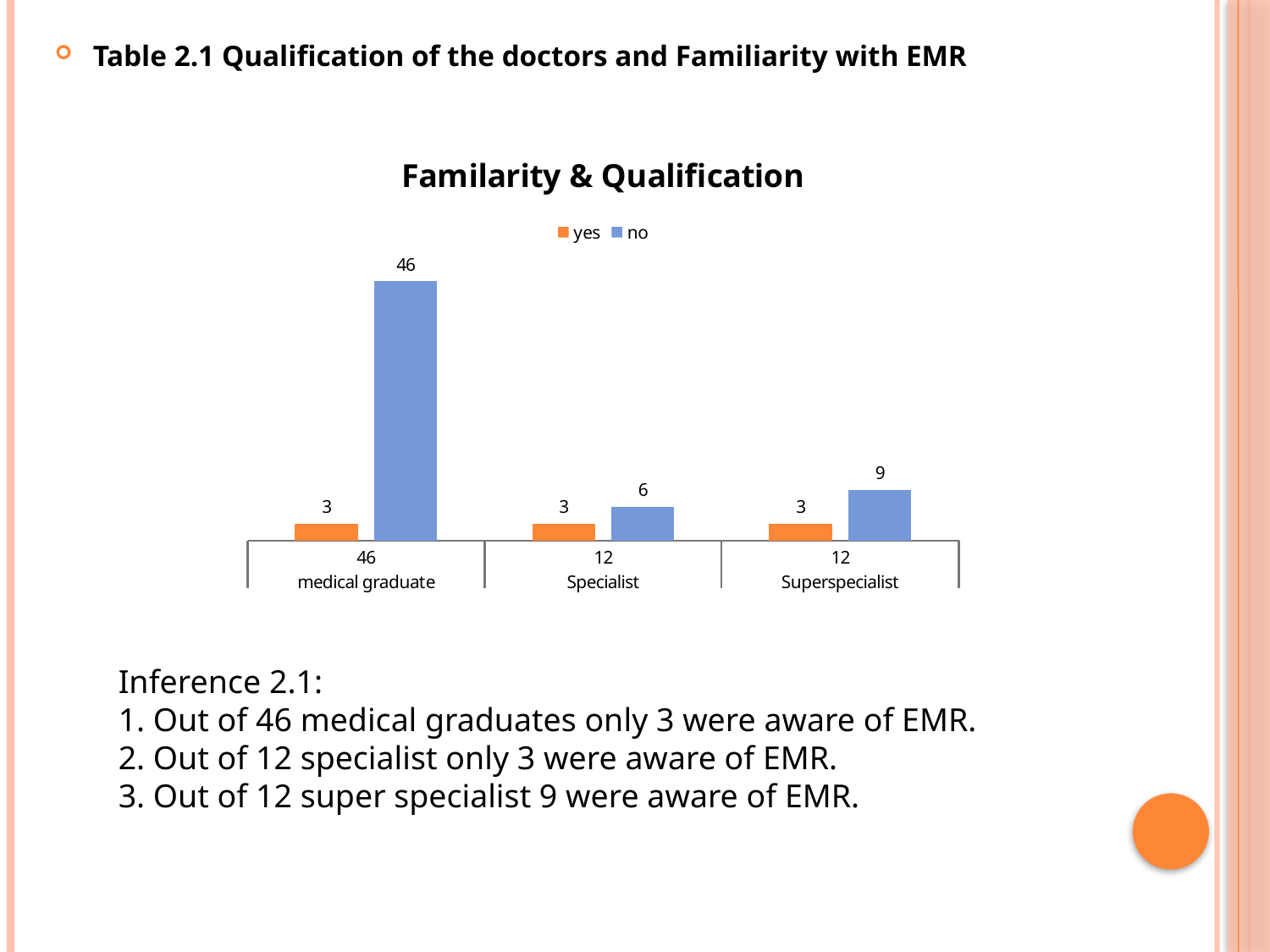
What is the value of the 'no' series for medical graduate? 46 What is the title of the chart? Familarity & Qualification What is the difference between the 'no' and 'yes' values for medical graduate? 43 What is the value of the 'no' series for Superspecialist? 9 How many series does the chart's legend list? 2 Which category has the highest value in the 'no' series? medical graduate What kind of chart is shown on the slide? bar chart What is the value of the 'yes' series for Specialist? 3 How many qualification categories are shown on the x axis of the chart? 3 Which category has the lowest value in the 'no' series? Specialist Which colour represents the 'yes' series in the chart? orange Which is larger for Superspecialist: the 'yes' value or the 'no' value? no